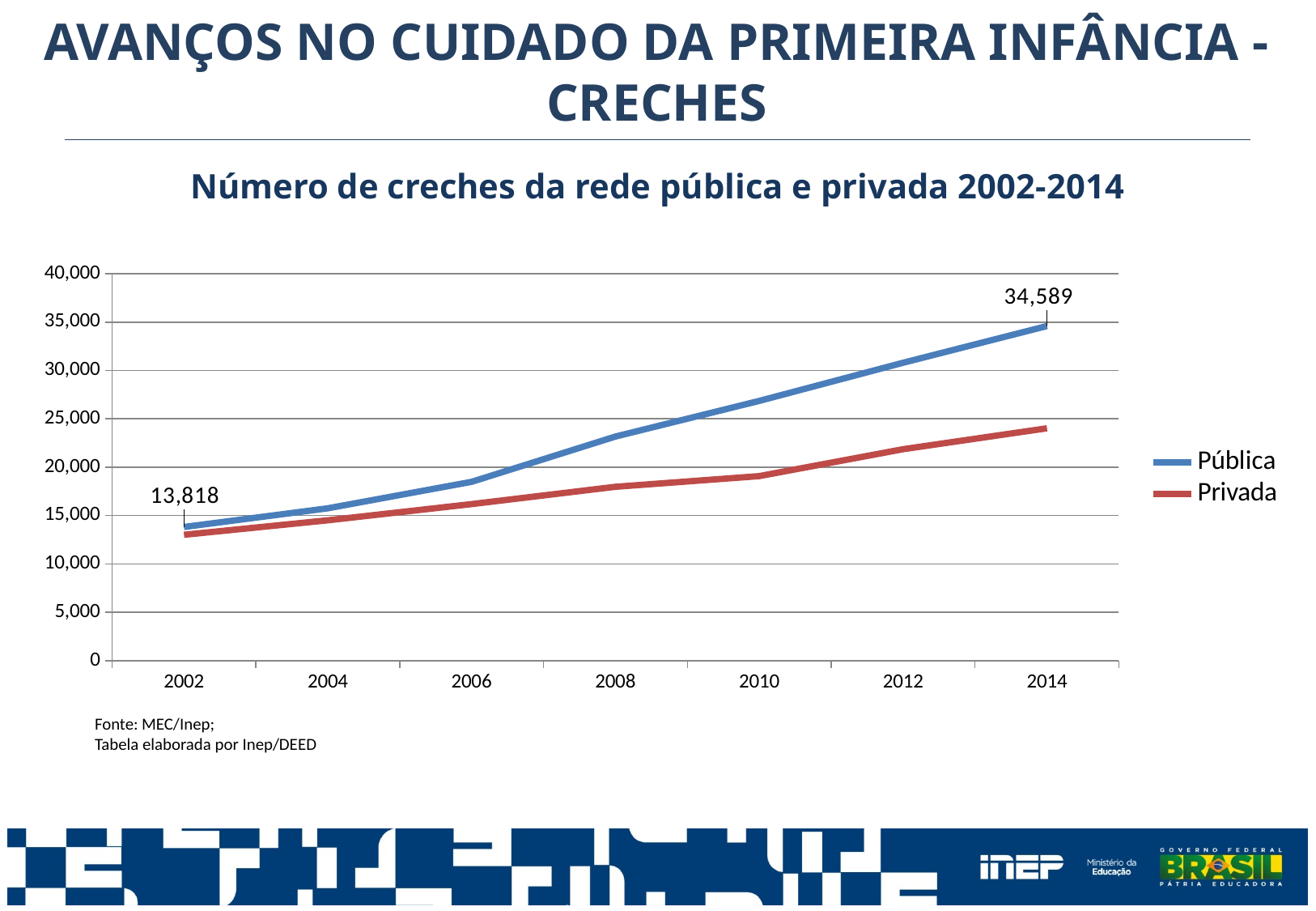
In which year does the Pública series reach its highest value? 2014 Is the value for Pública in 2010 greater or less than 25,000? greater Is the value for Privada in 2002 greater or less than 15,000? less In 2014, which series has the larger value, Pública or Privada? Pública Is the value for Privada in 2014 greater or less than 20,000? greater What is the value for Pública in 2002? 13,818 What is the difference between the Pública value in 2014 and the Pública value in 2002? 20,771 What kind of chart is shown on the slide? line chart What colour is the line for Privada? red How many series does the legend list? 2 What is the value for Pública in 2014? 34,589 Do the values for Pública rise or fall from 2002 to 2014? rise